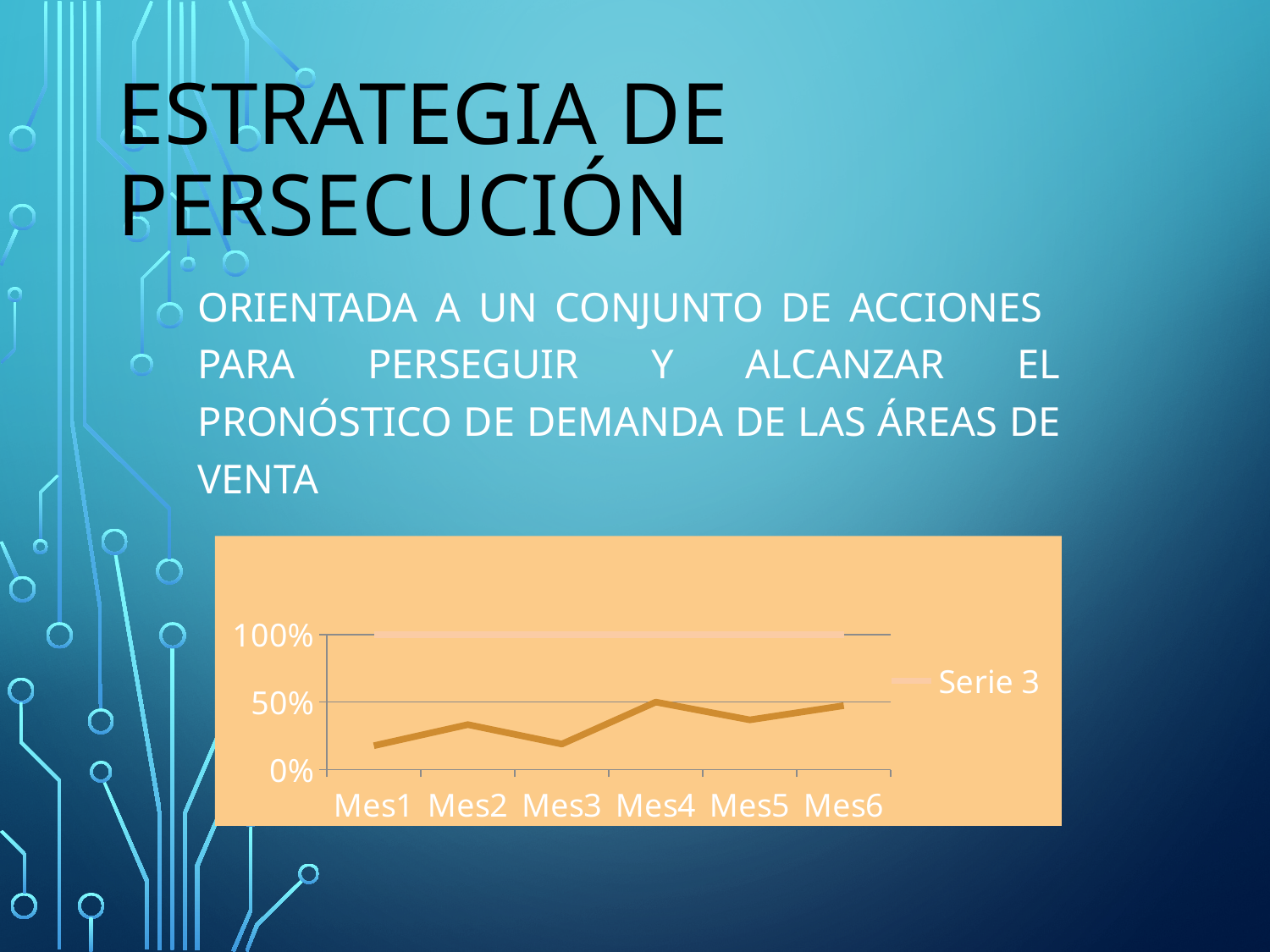
On the orange line, which is larger, the value for Mes1 or the value for Mes2? Mes2 How many months (categories) are shown on the x axis of the chart? 6 Is the value of the orange line for Mes3 greater or less than 50%? less What kind of chart is shown on the slide? line chart Is the value of the orange line for Mes1 greater or less than 50%? less On the orange line, which is larger, the value for Mes3 or the value for Mes4? Mes4 Does the orange line generally rise or fall from Mes1 to Mes6? rise Is the value of the orange line for Mes2 greater or less than 50%? less What is the name of the series shown in the chart legend? Serie 3 How many series does the chart legend list? 1 What is the highest value shown on the chart's vertical axis? 100%